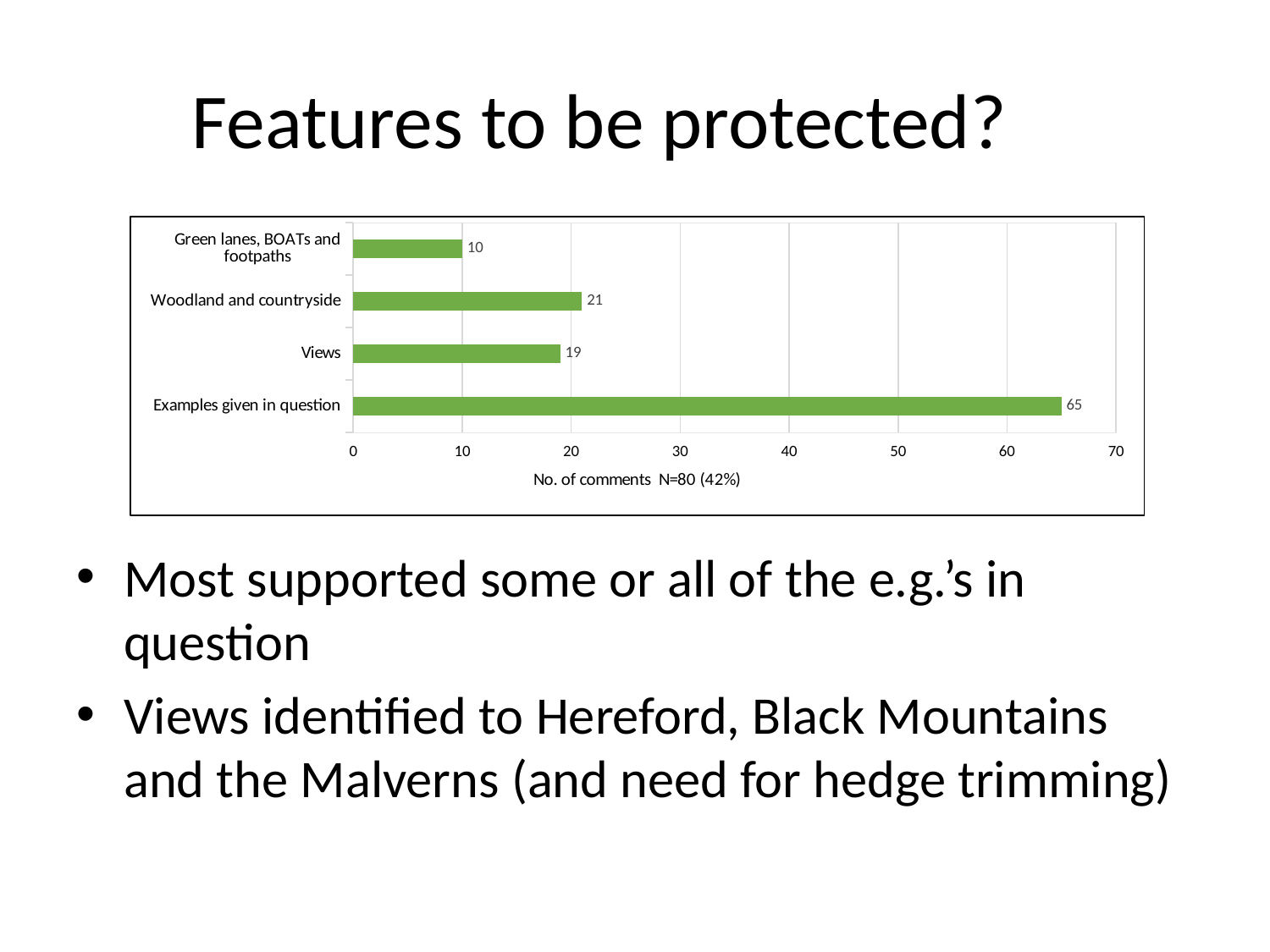
What is the number of comments for Green lanes, BOATs and footpaths? 10 What is the label on the horizontal axis of the chart? No. of comments N=80 (42%) What is the number of comments for Woodland and countryside? 21 How many categories are shown in the chart? 4 What kind of chart is shown on the slide? Bar chart Which category has the highest number of comments? Examples given in question Which category has the lowest number of comments? Green lanes, BOATs and footpaths Which has more comments, Woodland and countryside or Views? Woodland and countryside What is the difference in number of comments between Examples given in question and Woodland and countryside? 44 What is the difference in number of comments between Views and Green lanes, BOATs and footpaths? 9 What is the number of comments for Examples given in question? 65 What is the number of comments for Views? 19